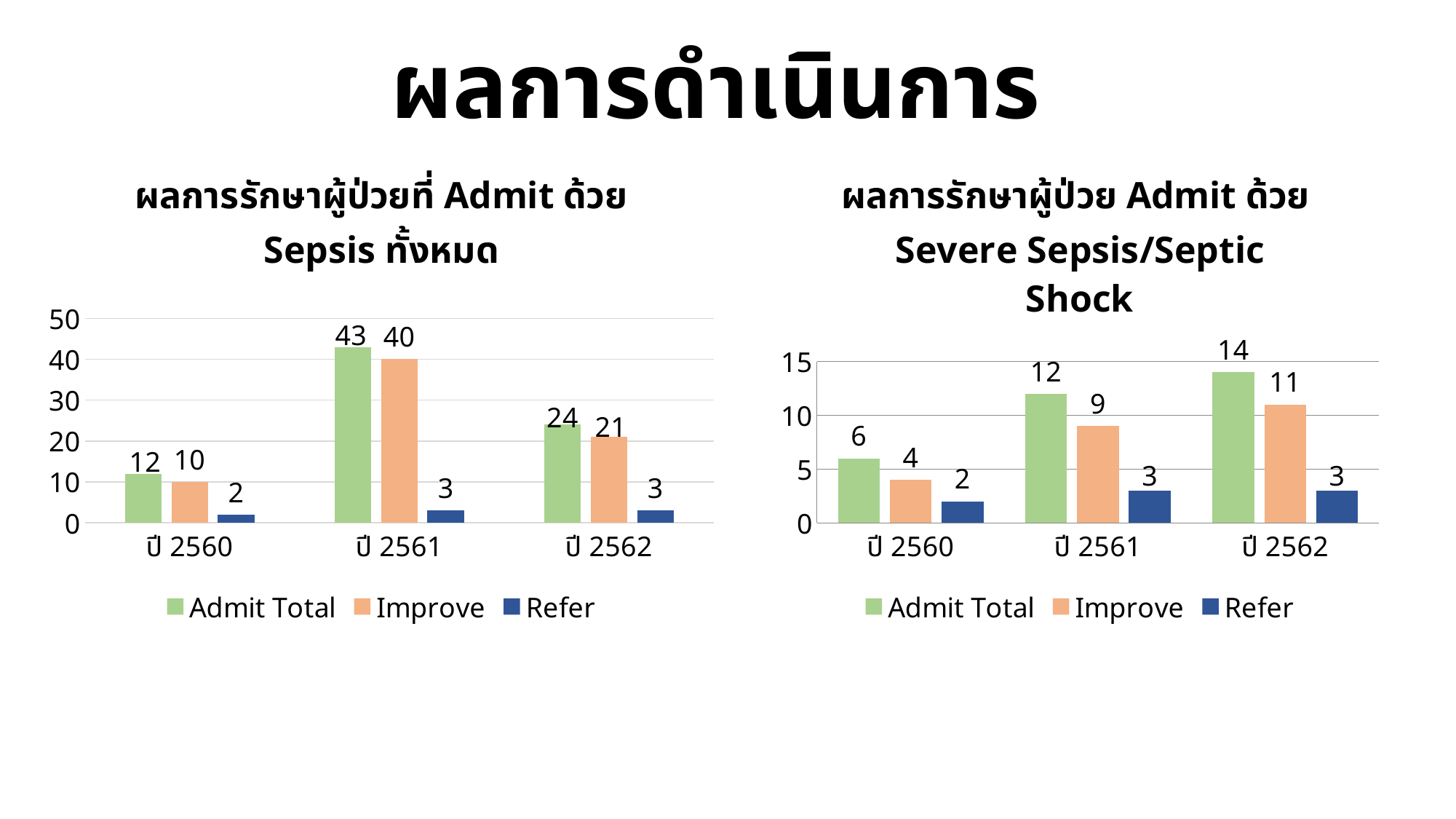
What kind of chart is the left chart (Sepsis ทั้งหมด)? bar chart In the right chart (Severe Sepsis/Septic Shock), does the Admit Total rise or fall from ปี 2560 to ปี 2562? rise In the left chart (Sepsis ทั้งหมด), what is the Refer value for ปี 2560? 2 In the right chart (Severe Sepsis/Septic Shock), what is the difference between Admit Total for ปี 2561 and ปี 2560? 6 In the right chart (Severe Sepsis/Septic Shock), is the Improve value for ปี 2561 larger or smaller than the Improve value for ปี 2562? smaller In the right chart (Severe Sepsis/Septic Shock), what is the Improve value for ปี 2562? 11 How many years are shown on the x axis of the left chart (Sepsis ทั้งหมด)? 3 In the left chart (Sepsis ทั้งหมด), what is the Admit Total value for ปี 2561? 43 In the left chart (Sepsis ทั้งหมด), which year has the lowest Improve value? ปี 2560 In the left chart (Sepsis ทั้งหมด), what is the difference between Admit Total and Improve for ปี 2562? 3 In the right chart (Severe Sepsis/Septic Shock), which year has the highest Admit Total? ปี 2562 How many series does the legend of the right chart (Severe Sepsis/Septic Shock) list? 3